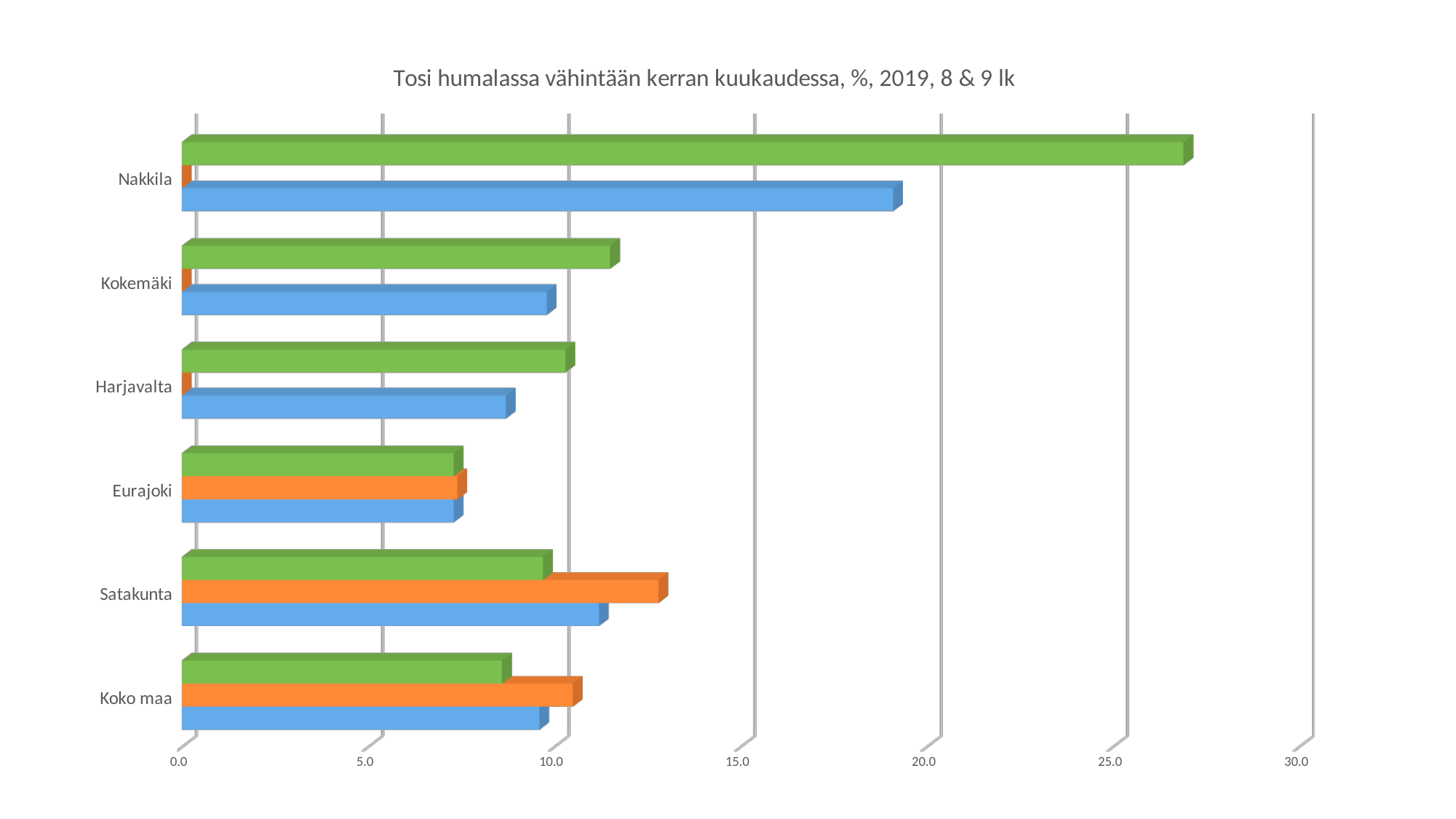
For Satakunta, which is larger: the orange bar or the blue bar? the orange bar Is the value of the green bar for Koko maa greater or less than 10.0? less How many categories are shown on the vertical axis of the chart? 6 What is the title of the chart? Tosi humalassa vähintään kerran kuukaudessa, %, 2019, 8 & 9 lk Which category has the longest green bar? Nakkila Is the value of the orange bar for Satakunta greater or less than 10.0? greater What kind of chart is shown on the slide? bar chart For Nakkila, which is larger: the green bar or the blue bar? the green bar Is the value of the blue bar for Nakkila greater or less than 20.0? less